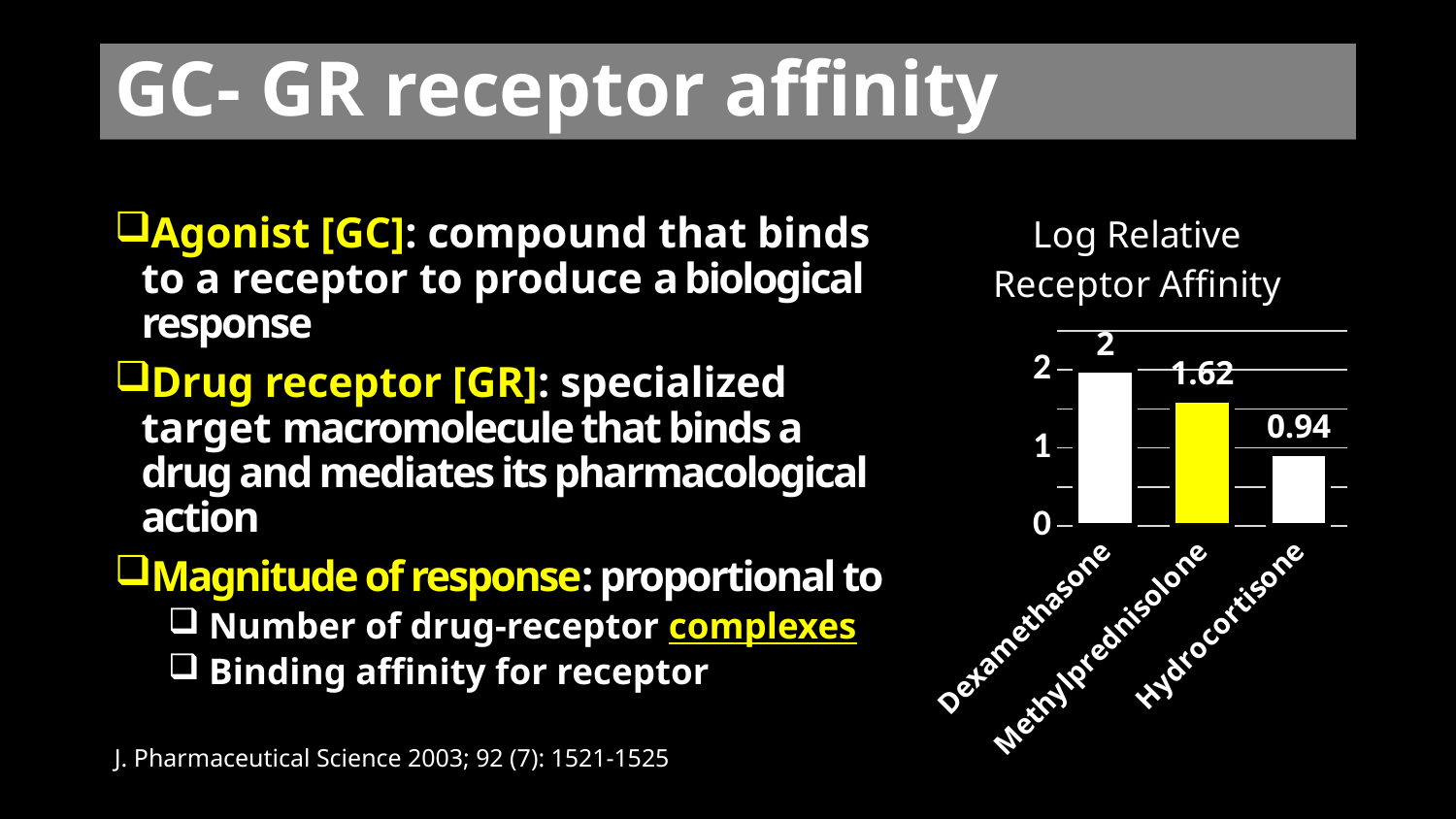
What is the Log Relative Receptor Affinity value for Methylprednisolone? 1.62 What is the Log Relative Receptor Affinity value for Hydrocortisone? 0.94 What is the Log Relative Receptor Affinity value for Dexamethasone? 2 What is the difference between the Log Relative Receptor Affinity of Methylprednisolone and Hydrocortisone? 0.68 Which drug has the lowest Log Relative Receptor Affinity? Hydrocortisone What is the difference between the Log Relative Receptor Affinity of Dexamethasone and Hydrocortisone? 1.06 What kind of chart is used to show Log Relative Receptor Affinity? Bar chart Which has a larger Log Relative Receptor Affinity, Methylprednisolone or Hydrocortisone? Methylprednisolone Which bar in the Log Relative Receptor Affinity chart is coloured yellow? Methylprednisolone Which drug has the highest Log Relative Receptor Affinity? Dexamethasone How many drugs are shown in the Log Relative Receptor Affinity chart? 3 Is the Log Relative Receptor Affinity for Hydrocortisone greater or less than 1? less